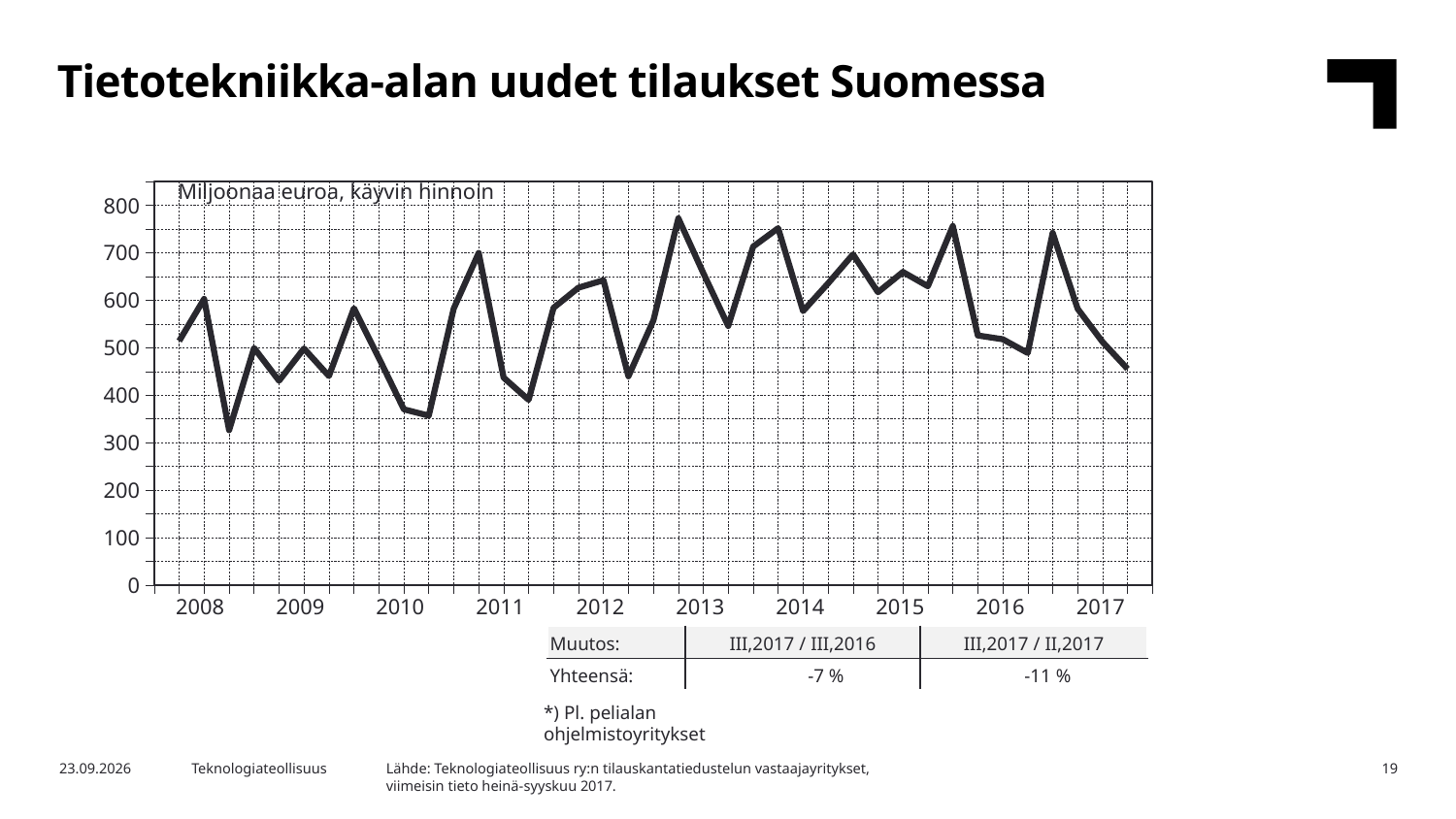
In what unit are the values of the chart expressed, according to the label inside the plot area? Miljoonaa euroa, käyvin hinnoin According to the table below the chart, what is the change (Muutos) for Yhteensä between III,2017 and II,2017? -11 % Is the lowest point of the line in 2010 greater or less than 400? less Is the lowest point of the line in 2008 greater or less than 400? less Is the peak of the line in 2016 greater or less than 700? greater What is the title of the chart on the slide? Tietotekniikka-alan uudet tilaukset Suomessa From the peak in 2016 to the last point in 2017, do the values rise or fall? fall According to the table below the chart, what is the change (Muutos) for Yhteensä between III,2017 and III,2016? -7 % What kind of chart is shown on the slide? line chart How many year labels are shown on the x axis of the chart? 10